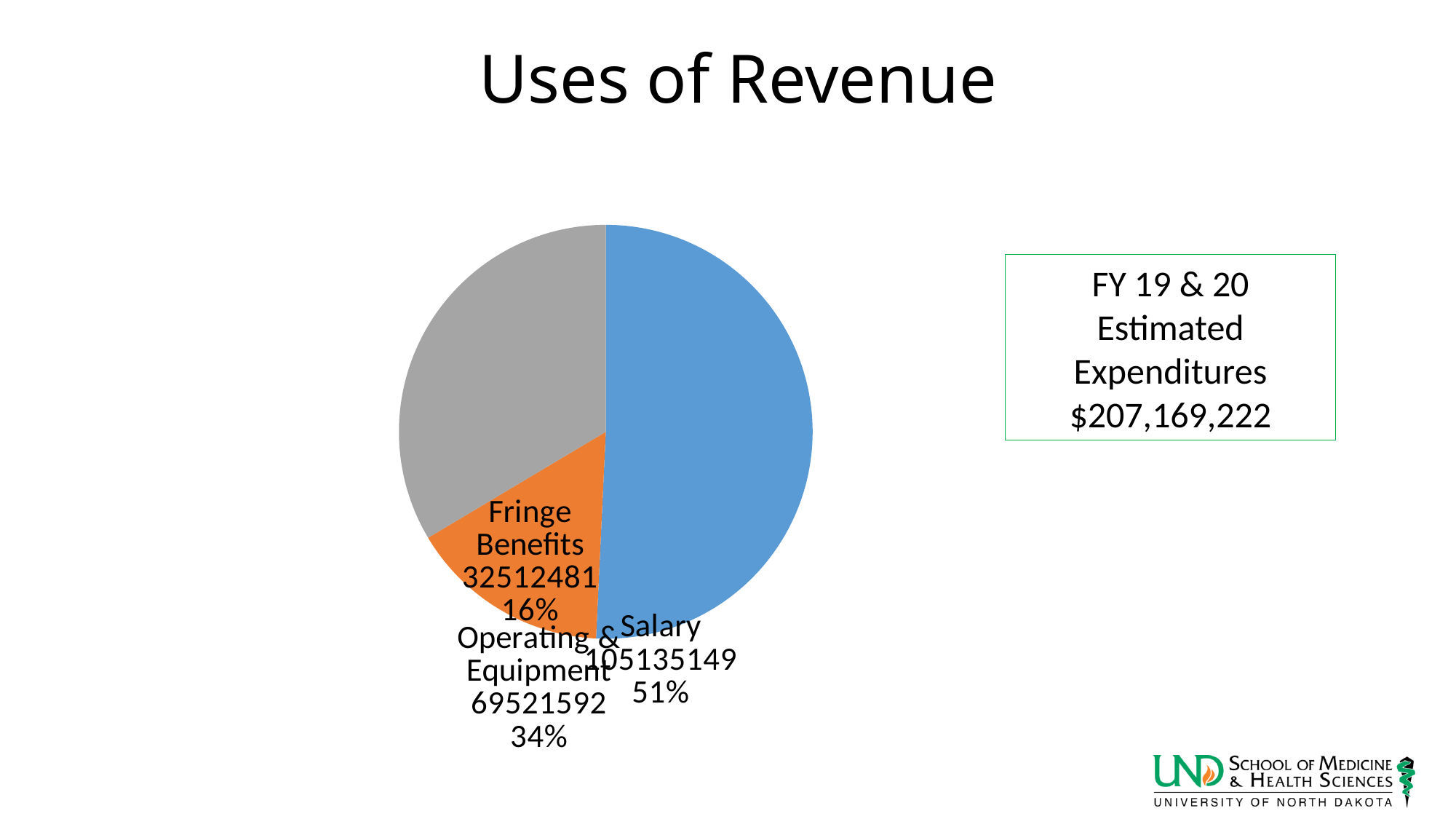
How many slices does the pie chart have? 3 What share of the pie does Operating & Equipment represent? 34% Which category has the smallest slice of the pie? Fringe Benefits What value is shown for Salary? 105135149 What share of the pie does Salary represent? 51% Which category has the largest slice of the pie? Salary What share of the pie does Fringe Benefits represent? 16% What value is shown for Fringe Benefits? 32512481 Which is larger, Operating & Equipment or Fringe Benefits? Operating & Equipment What value is shown for Operating & Equipment? 69521592 What kind of chart is shown on the slide? Pie chart What is the title of the chart on the slide? Uses of Revenue